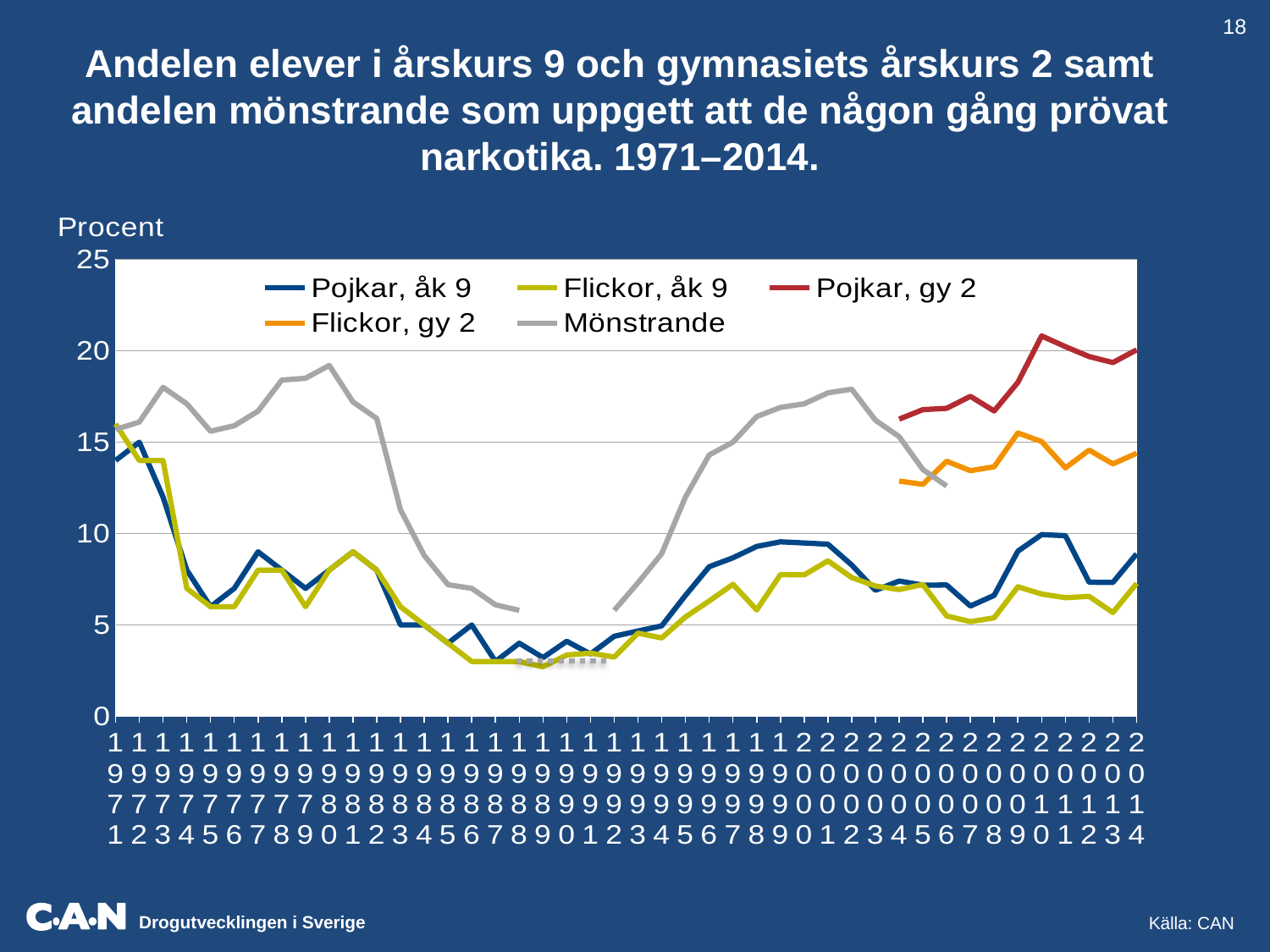
Which series reaches the highest value anywhere on the chart? Pojkar, gy 2 What kind of chart is shown on the slide? Line chart Is the value for Flickor, gy 2 in 2004 greater or less than 10? greater Is the value for Flickor, åk 9 in 1989 greater or less than 5? less In 1980, which is higher: Mönstrande or Pojkar, åk 9? Mönstrande Does the Mönstrande line rise or fall between 1980 and 1990? Fall What is the label on the vertical axis? Procent Is the value for Pojkar, gy 2 in 2005 greater or less than 15? greater How many series does the legend list? 5 Which series are listed in the legend? Pojkar, åk 9; Flickor, åk 9; Pojkar, gy 2; Flickor, gy 2; Mönstrande In 2014, which is higher: Pojkar, gy 2 or Flickor, gy 2? Pojkar, gy 2